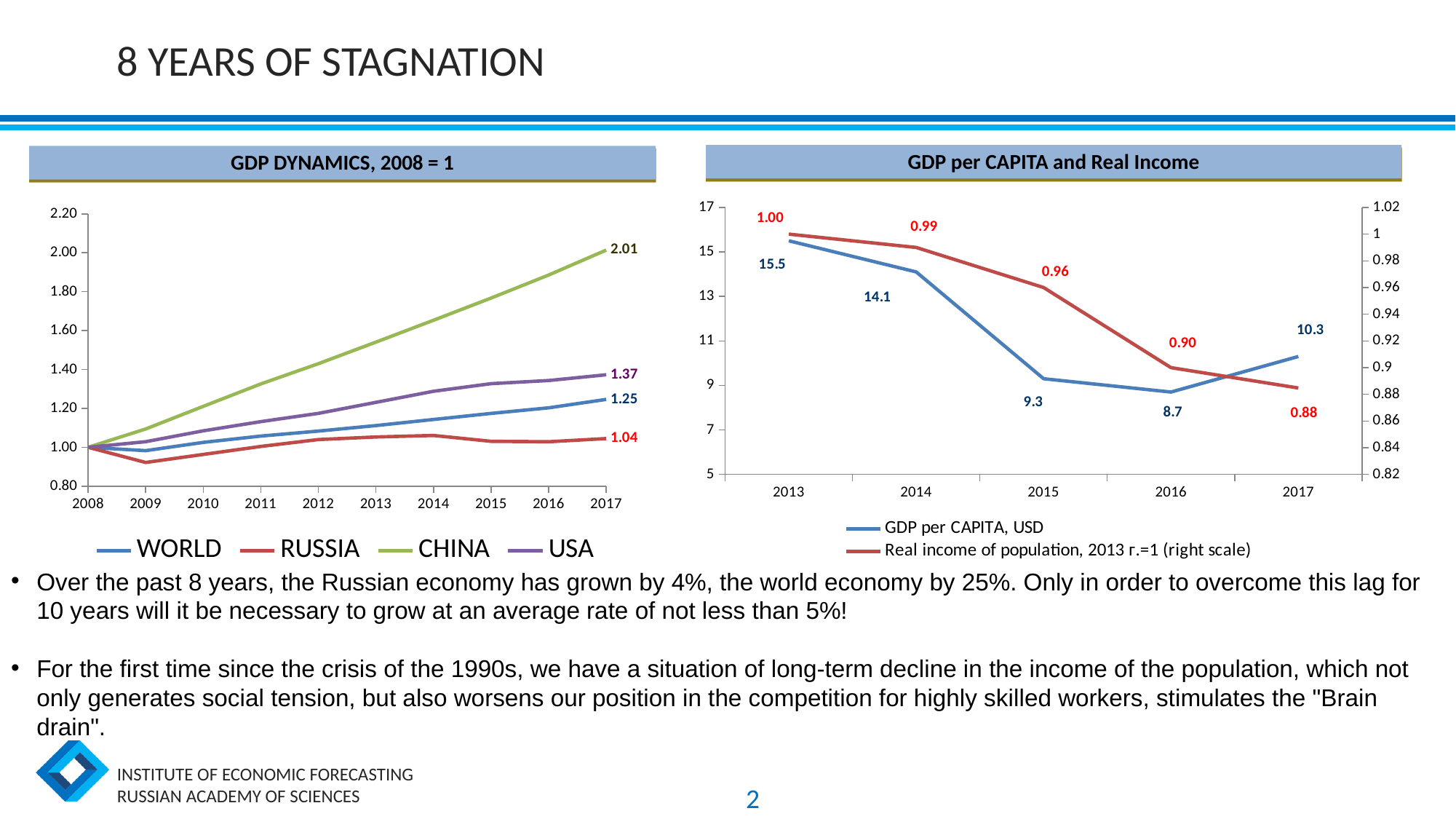
In the 'GDP per CAPITA and Real Income' chart, what is the difference in GDP per capita between 2013 and 2016? 6.8 In the 'GDP per CAPITA and Real Income' chart, what is the GDP per capita value for 2015? 9.3 In the 'GDP DYNAMICS, 2008 = 1' chart, how many series does the legend list? 4 What kind of chart is 'GDP DYNAMICS, 2008 = 1'? line chart In the 'GDP DYNAMICS, 2008 = 1' chart, what is the difference between the 2017 values for WORLD and RUSSIA? 0.21 In the 'GDP DYNAMICS, 2008 = 1' chart, what is the value for RUSSIA in 2017? 1.04 In the 'GDP per CAPITA and Real Income' chart, does real income of population rise or fall from 2013 to 2017? fall In the 'GDP DYNAMICS, 2008 = 1' chart, is the value for RUSSIA in 2009 greater or less than 1.00? less In the 'GDP DYNAMICS, 2008 = 1' chart, which series has the highest value in 2017? CHINA In the 'GDP DYNAMICS, 2008 = 1' chart, what is the value for CHINA in 2017? 2.01 In the 'GDP per CAPITA and Real Income' chart, in which year is GDP per capita lowest? 2016 In the 'GDP per CAPITA and Real Income' chart, what is the real income value for 2017? 0.88